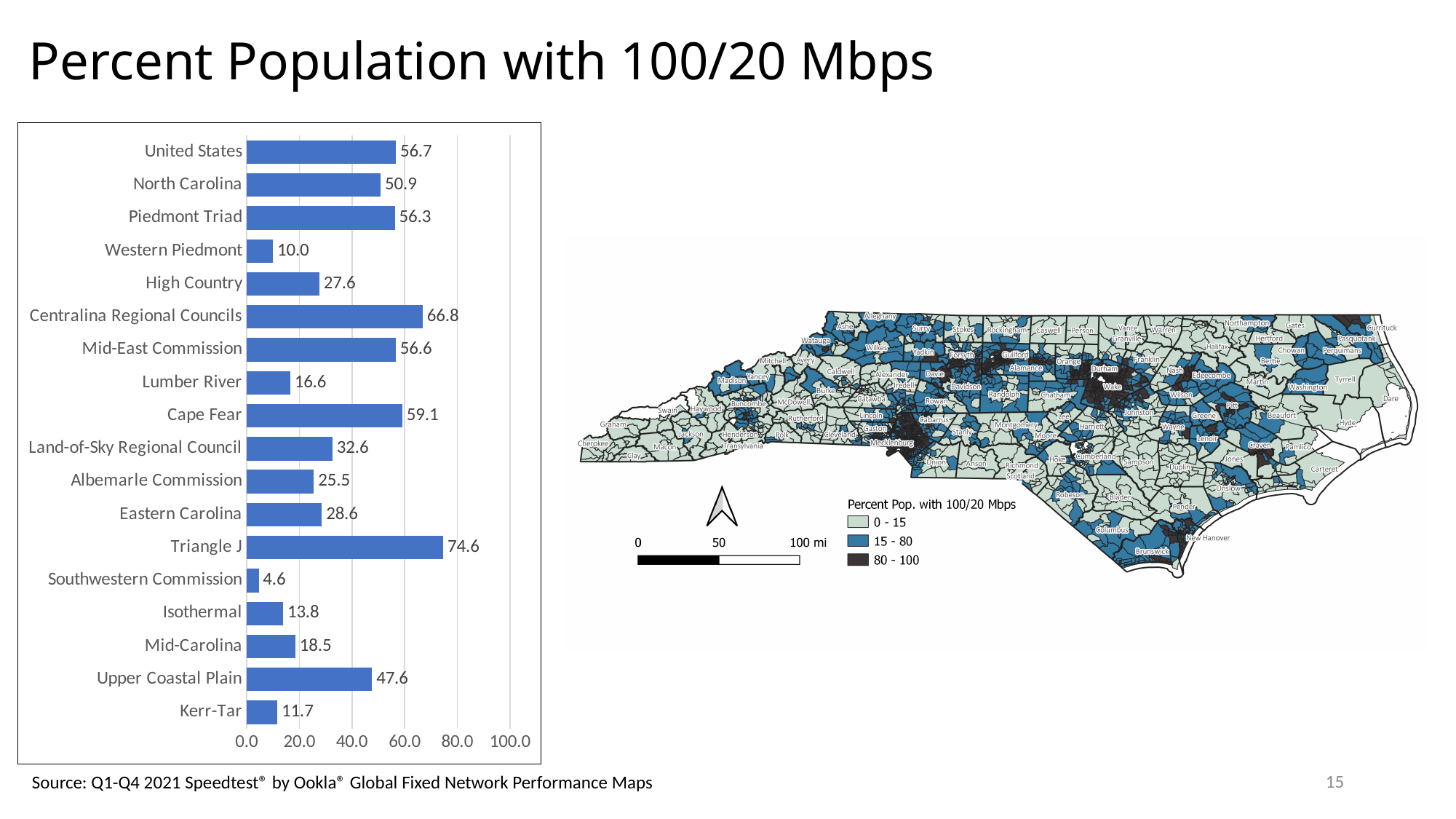
How many categories are shown in the bar chart? 18 What is the value for Western Piedmont in the bar chart? 10.0 What is the difference between the values for Triangle J and Centralina Regional Councils in the bar chart? 7.8 What is the value for Triangle J in the bar chart? 74.6 What is the difference between the values for United States and North Carolina in the bar chart? 5.8 Which category has the highest value in the bar chart? Triangle J What is the value for North Carolina in the bar chart? 50.9 What kind of chart is shown on the left of the slide? bar chart What is the title of the slide? Percent Population with 100/20 Mbps Which has a larger value in the bar chart, Cape Fear or Upper Coastal Plain? Cape Fear Which category has the lowest value in the bar chart? Southwestern Commission Is the value for Land-of-Sky Regional Council in the bar chart greater or less than 40.0? less